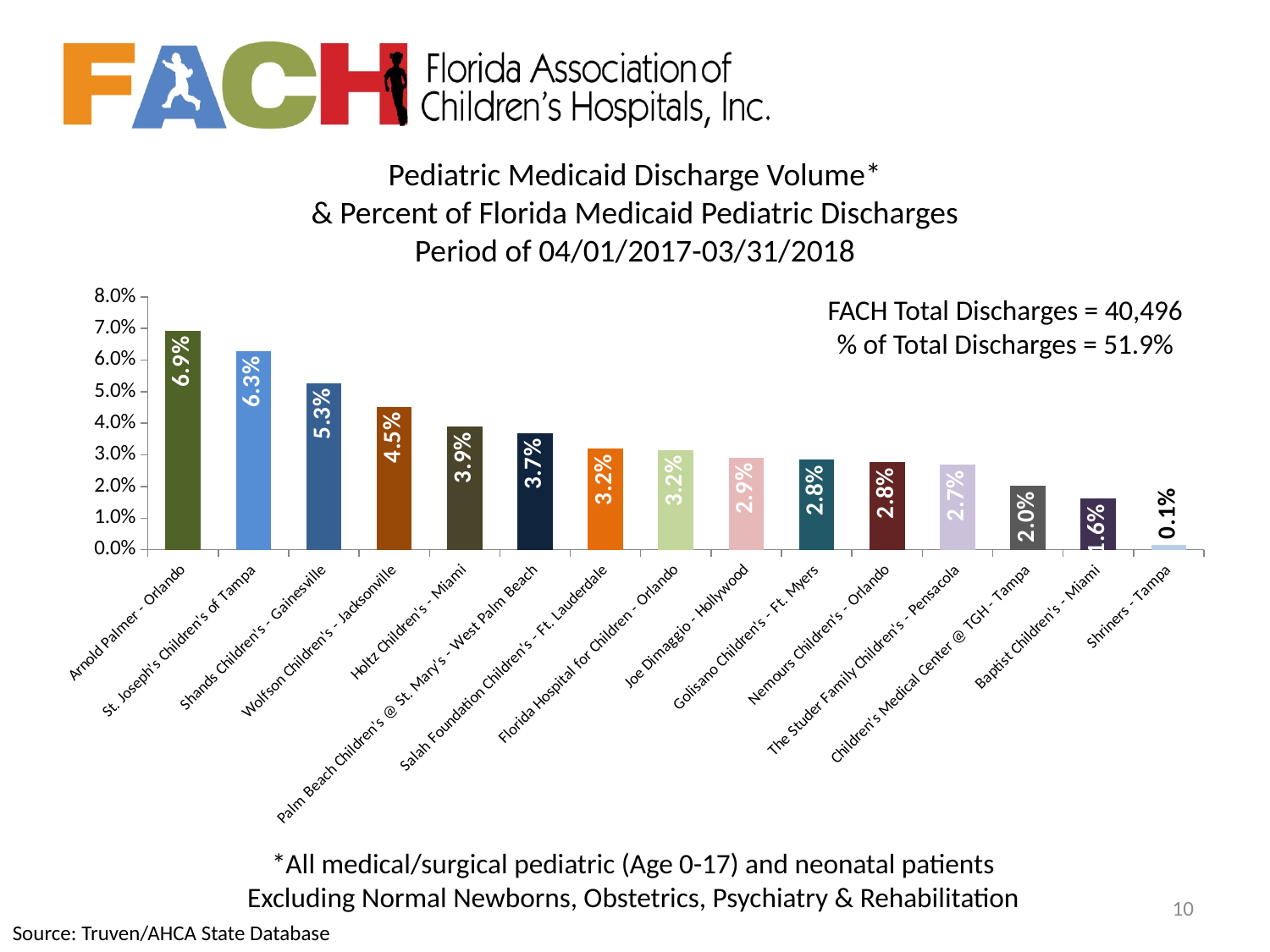
Which hospital has the highest percent of Florida Medicaid pediatric discharges? Arnold Palmer - Orlando What is the value for Joe Dimaggio - Hollywood? 2.9% Is the value for Children's Medical Center @ TGH - Tampa greater or less than 3.0%? less What is the difference between the values for St. Joseph's Children's of Tampa and Shands Children's - Gainesville? 1.0% What is the value for Baptist Children's - Miami? 1.6% What is the value for Wolfson Children's - Jacksonville? 4.5% Which hospital has the lowest percent of Florida Medicaid pediatric discharges? Shriners - Tampa What is the FACH Total Discharges figure stated on the chart? 40,496 How many hospitals are shown in the chart? 15 What kind of chart is shown on the slide? bar chart Which is larger, the value for Holtz Children's - Miami or the value for Nemours Children's - Orlando? Holtz Children's - Miami What is the value for Arnold Palmer - Orlando? 6.9%